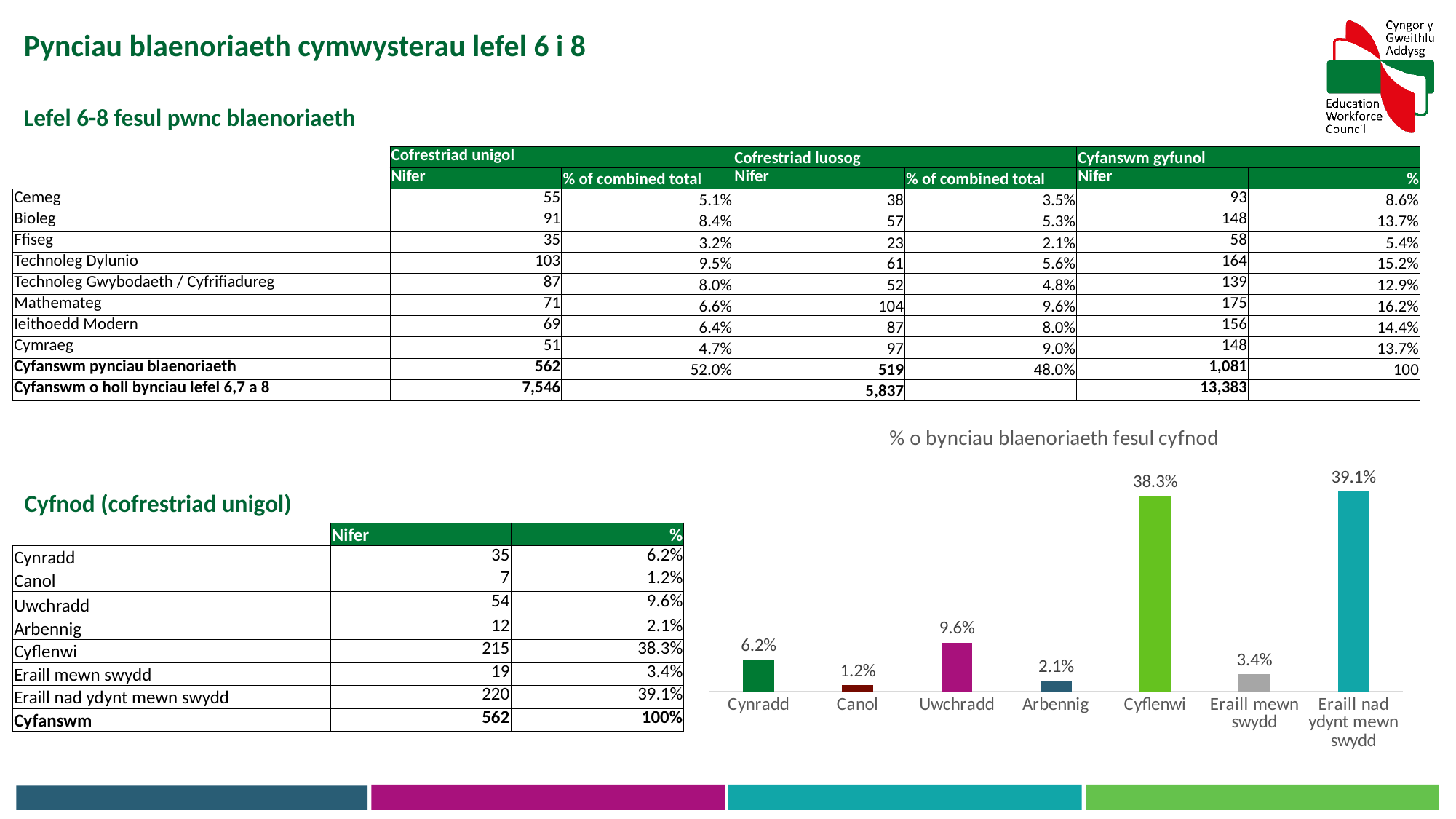
What is the difference between the values for Uwchradd and Cynradd? 3.4% What is the value for Uwchradd in the chart? 9.6% What is the value for Cyflenwi in the chart? 38.3% What is the value for Canol in the chart? 1.2% What kind of chart is shown on the slide? Bar chart What is the difference between the values for Eraill nad ydynt mewn swydd and Cyflenwi? 0.8% What is the value for Eraill mewn swydd in the chart? 3.4% Which category has the highest value in the chart? Eraill nad ydynt mewn swydd Which is larger, the value for Cynradd or the value for Arbennig? Cynradd Which category has the lowest value in the chart? Canol How many categories are shown in the chart? 7 What is the title of the chart? % o bynciau blaenoriaeth fesul cyfnod